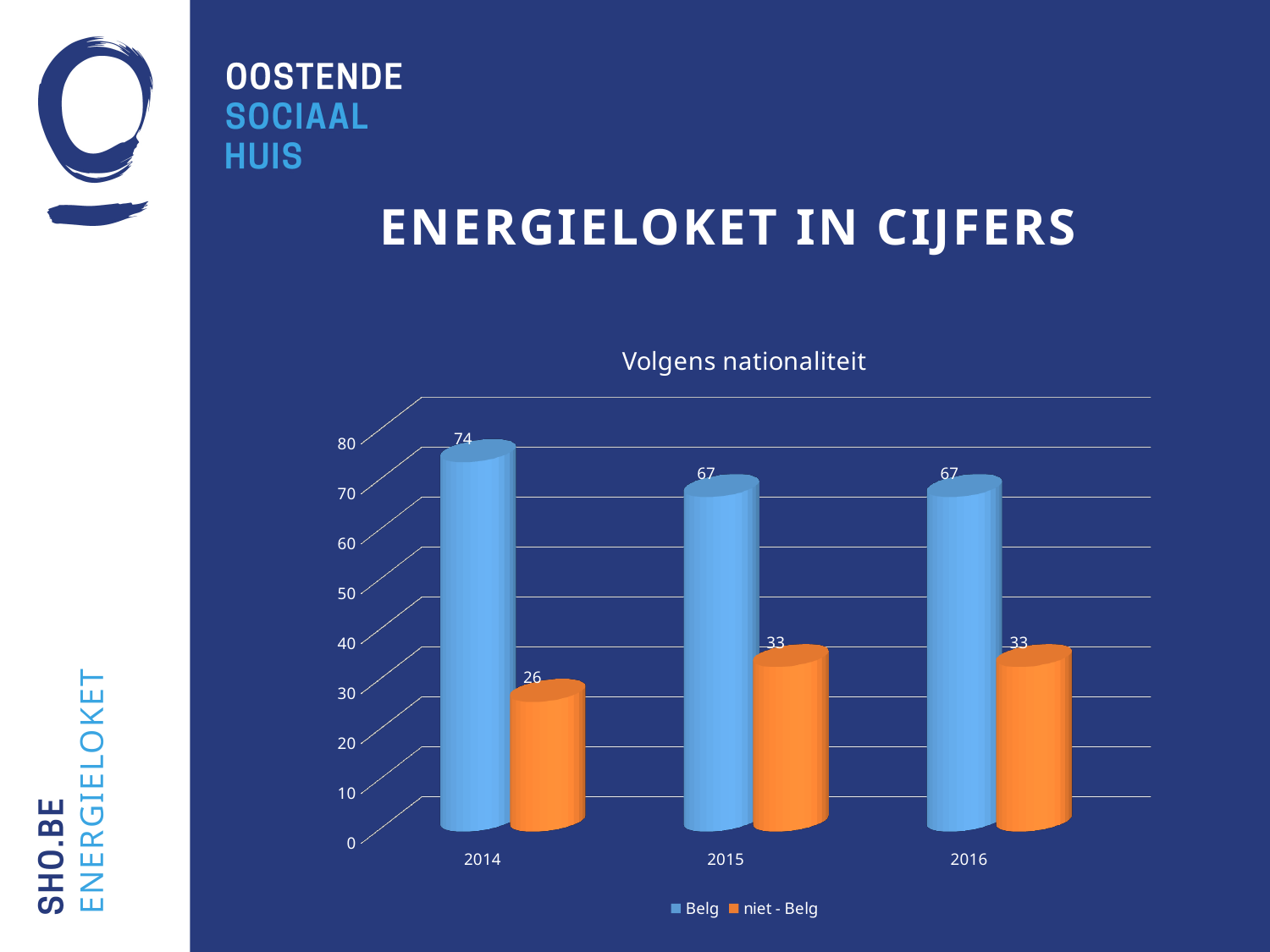
How many years are shown on the x axis? 3 Which is larger in 2015, the Belg value or the niet - Belg value? Belg What is the value for niet - Belg in 2014? 26 What is the value for niet - Belg in 2015? 33 In which year is the Belg value highest? 2014 How many series does the legend list? 2 What kind of chart is shown? bar chart Does the Belg value rise or fall from 2014 to 2015? fall What is the value for Belg in 2014? 74 In which year is the niet - Belg value lowest? 2014 What is the title of the chart? Volgens nationaliteit What is the difference between the Belg and niet - Belg values in 2016? 34